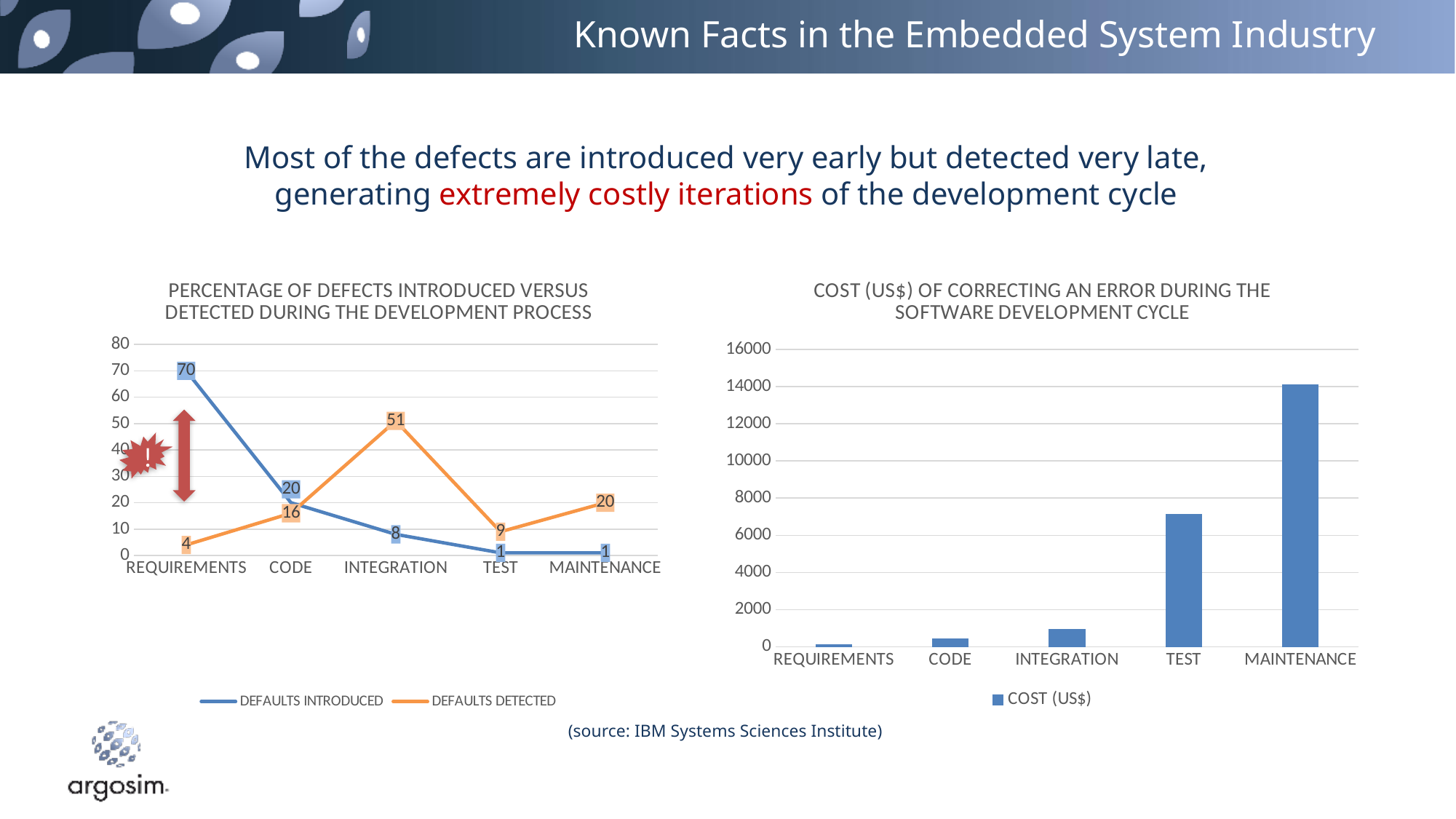
In the 'Percentage of defects introduced versus detected' chart, what is the value of Defaults Introduced for Requirements? 70 In the 'Percentage of defects introduced versus detected' chart, what is the value of Defaults Detected for Maintenance? 20 In the 'Percentage of defects introduced versus detected' chart, how many series does the legend list? 2 In the 'Percentage of defects introduced versus detected' chart, does the Defaults Introduced series rise or fall from Requirements to Maintenance? fall In the 'Cost (US$) of correcting an error' chart, which phase has the highest cost? Maintenance In the 'Percentage of defects introduced versus detected' chart, what is the value of Defaults Detected for Integration? 51 In the 'Percentage of defects introduced versus detected' chart, which is larger for Code: Defaults Introduced or Defaults Detected? Defaults Introduced In the 'Cost (US$) of correcting an error' chart, is the value for Test greater or less than 6000? greater What kind of chart is the 'Cost (US$) of correcting an error during the software development cycle' chart? bar chart In the 'Percentage of defects introduced versus detected' chart, which phase has the highest Defaults Detected value? Integration In the 'Percentage of defects introduced versus detected' chart, what is the difference between Defaults Introduced and Defaults Detected for Requirements? 66 In the 'Cost (US$) of correcting an error' chart, how many phases are shown on the x axis? 5